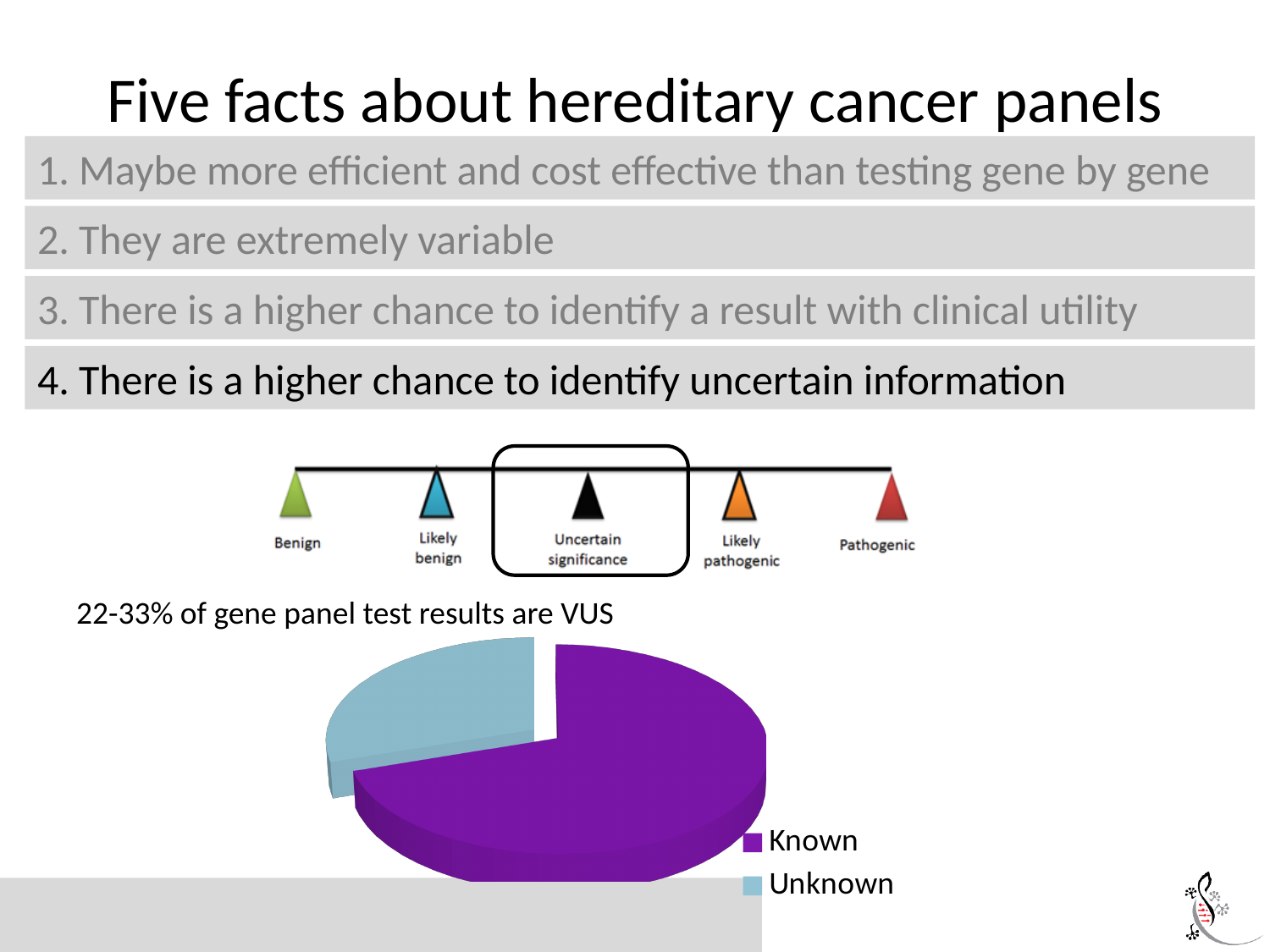
Does the Unknown slice make up more or less than half of the pie chart? less How many entries does the pie chart's legend list? 2 Does the Known slice make up more or less than half of the pie chart? more Which slice of the pie chart is larger, Known or Unknown? Known How many slices does the pie chart have? 2 What colour is the Unknown slice in the pie chart? light blue Which category takes up the largest share of the pie chart? Known Which category takes up the smallest share of the pie chart? Unknown What kind of chart is shown at the bottom of the slide? pie chart What colour is the Known slice in the pie chart? purple